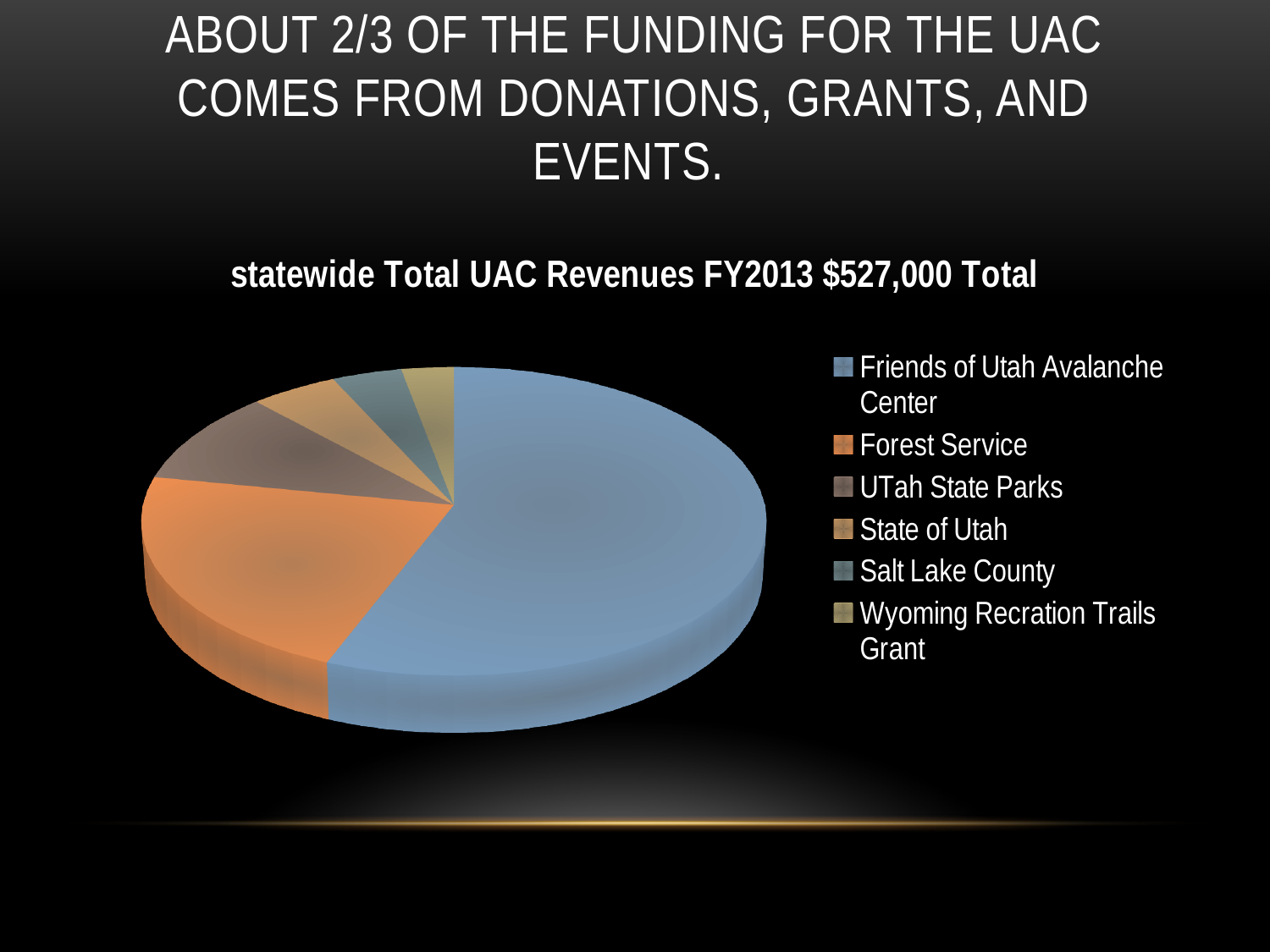
How many categories (slices) does the pie chart have? 6 What kind of chart is shown on the slide? pie chart Which category has the second-largest slice of the pie? Forest Service Which category has the largest slice of the pie? Friends of Utah Avalanche Center Which is larger, the slice for Forest Service or the slice for Salt Lake County? Forest Service Which is larger, the slice for Forest Service or the slice for UTah State Parks? Forest Service What total revenue amount is stated in the chart title? $527,000 What is the title of the chart? statewide Total UAC Revenues FY2013 $527,000 Total Which is larger, the slice for Friends of Utah Avalanche Center or the slice for Forest Service? Friends of Utah Avalanche Center Which fiscal year does the chart cover? FY2013